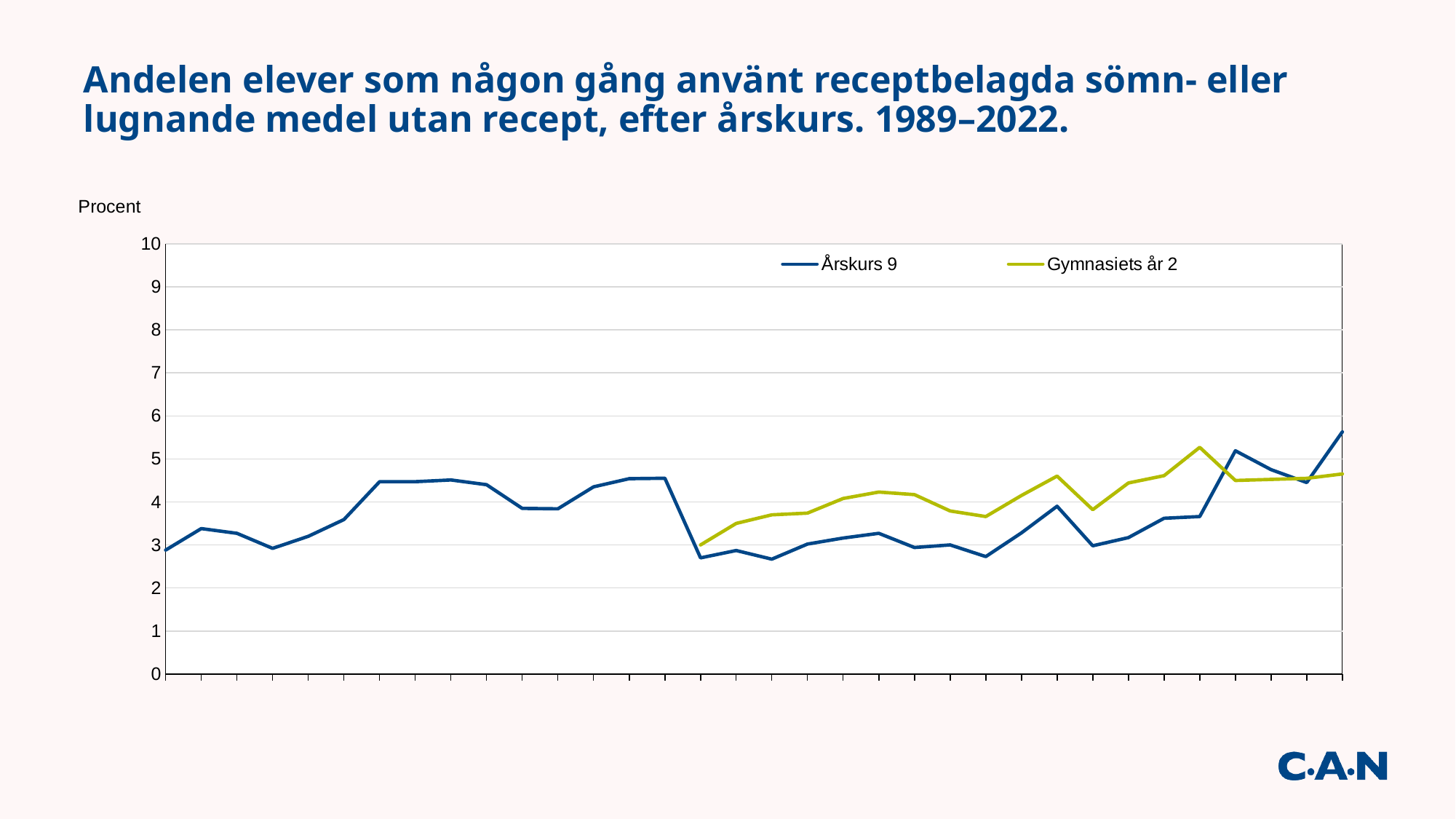
Is the lowest value of the Gymnasiets år 2 line greater or less than 4? less What kind of chart is shown on the slide? Line chart What label is shown on the vertical axis of the chart? Procent How many series does the legend list? 2 At the right-hand end of the chart, which series has the higher value, Årskurs 9 or Gymnasiets år 2? Årskurs 9 Is the first plotted value of the Årskurs 9 line greater or less than 4? less Does the Gymnasiets år 2 line generally rise or fall from its first point to its last point? rise Is the highest value of the Årskurs 9 line greater or less than 5? greater Which series starts later along the x axis, Årskurs 9 or Gymnasiets år 2? Gymnasiets år 2 What is the highest value shown on the vertical axis? 10 What are the two series named in the legend? Årskurs 9 and Gymnasiets år 2